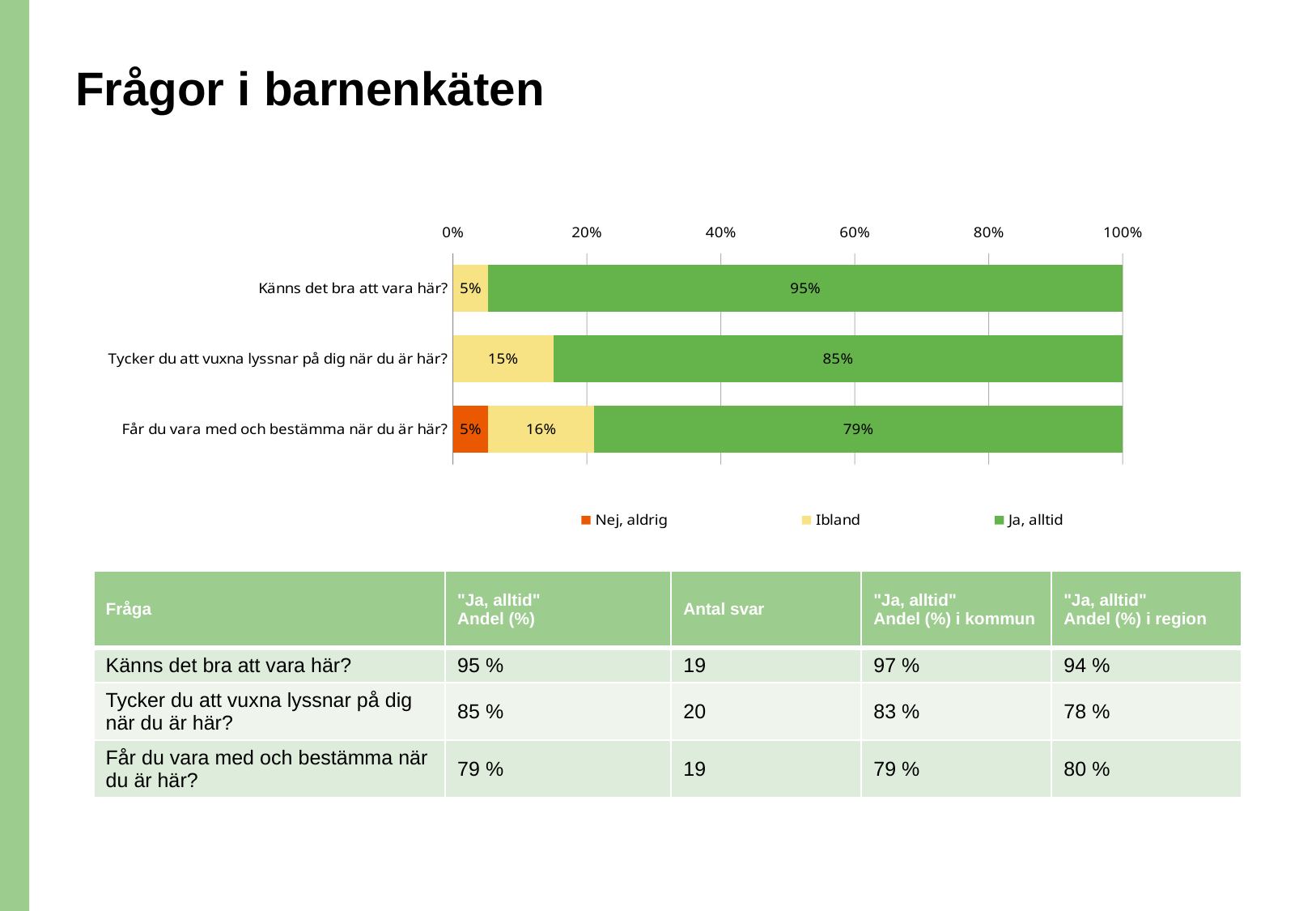
Which question has the highest "Ja, alltid" share? Känns det bra att vara här? What is the "Ibland" value for "Tycker du att vuxna lyssnar på dig när du är här?"? 15% How many series does the chart legend list? 3 Which is larger: the "Ibland" value for "Tycker du att vuxna lyssnar på dig när du är här?" or for "Känns det bra att vara här?"? Tycker du att vuxna lyssnar på dig när du är här? What is the difference between the "Ja, alltid" values for "Känns det bra att vara här?" and "Får du vara med och bestämma när du är här?"? 16% What is the "Nej, aldrig" value for "Får du vara med och bestämma när du är här?"? 5% How many questions (categories) are plotted in the chart? 3 Which question has the lowest "Ja, alltid" share? Får du vara med och bestämma när du är här? What is the "Ja, alltid" value for "Känns det bra att vara här?"? 95% Which legend entry is shown in orange? Nej, aldrig What is the "Ibland" value for "Får du vara med och bestämma när du är här?"? 16% What kind of chart is shown on the slide? Stacked bar chart